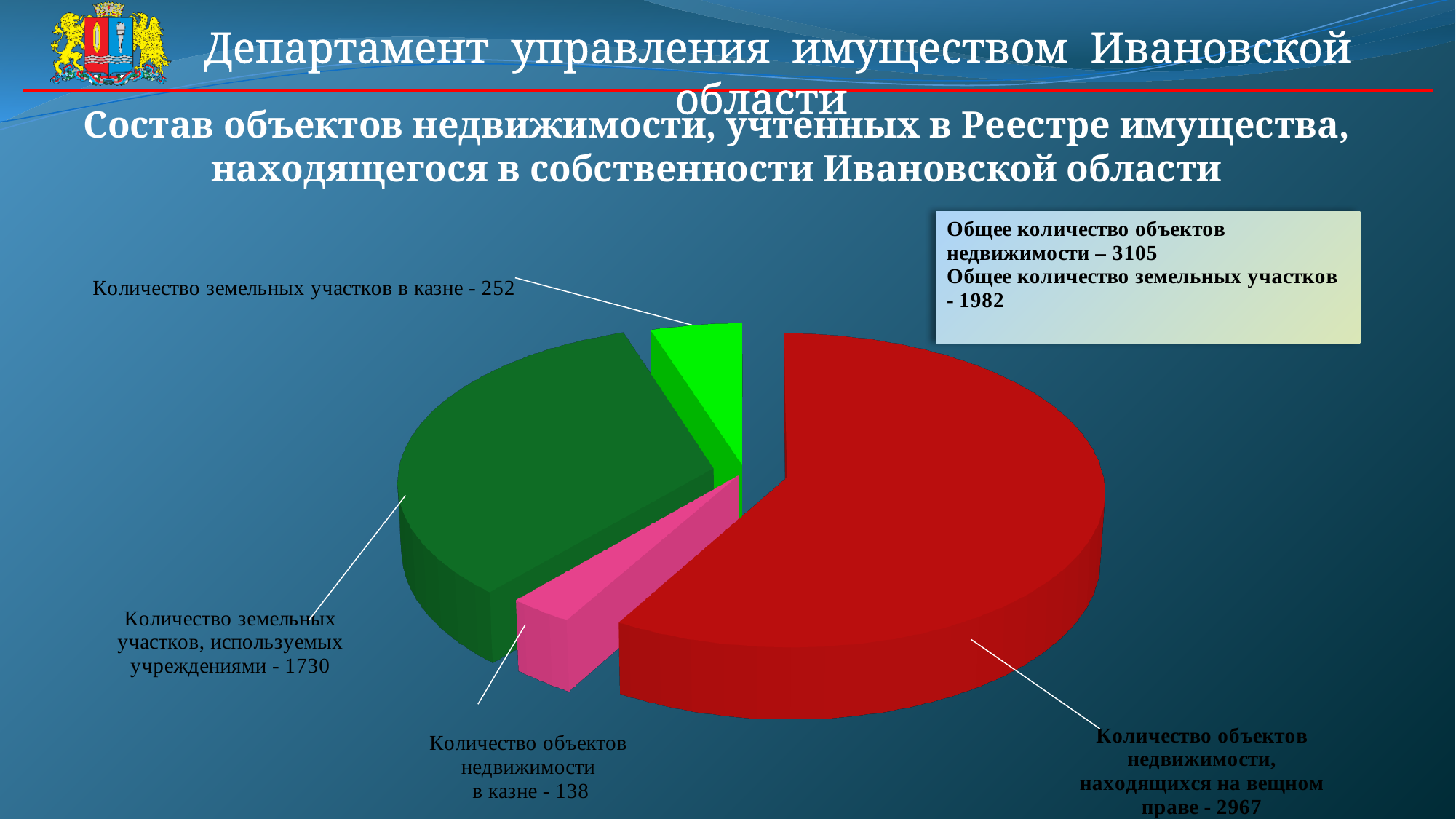
What is the value for "Количество земельных участков в казне"? 252 How many slices does the pie chart have? 4 What is the value for "Количество объектов недвижимости в казне"? 138 What colour is the slice for "Количество объектов недвижимости в казне"? pink Which category has the smallest slice of the pie? Количество объектов недвижимости в казне Which category has the largest slice of the pie? Количество объектов недвижимости, находящихся на вещном праве According to the text box on the slide, what is the total number of land plots (Общее количество земельных участков)? 1982 What is the value for "Количество объектов недвижимости, находящихся на вещном праве"? 2967 What is the difference between the number of real estate objects on property right (вещное право) and the number of land plots used by institutions? 1237 Which is larger: the number of land plots in the treasury (в казне) or the number of real estate objects in the treasury? Количество земельных участков в казне What is the value for "Количество земельных участков, используемых учреждениями"? 1730 What kind of chart is shown on the slide? pie chart